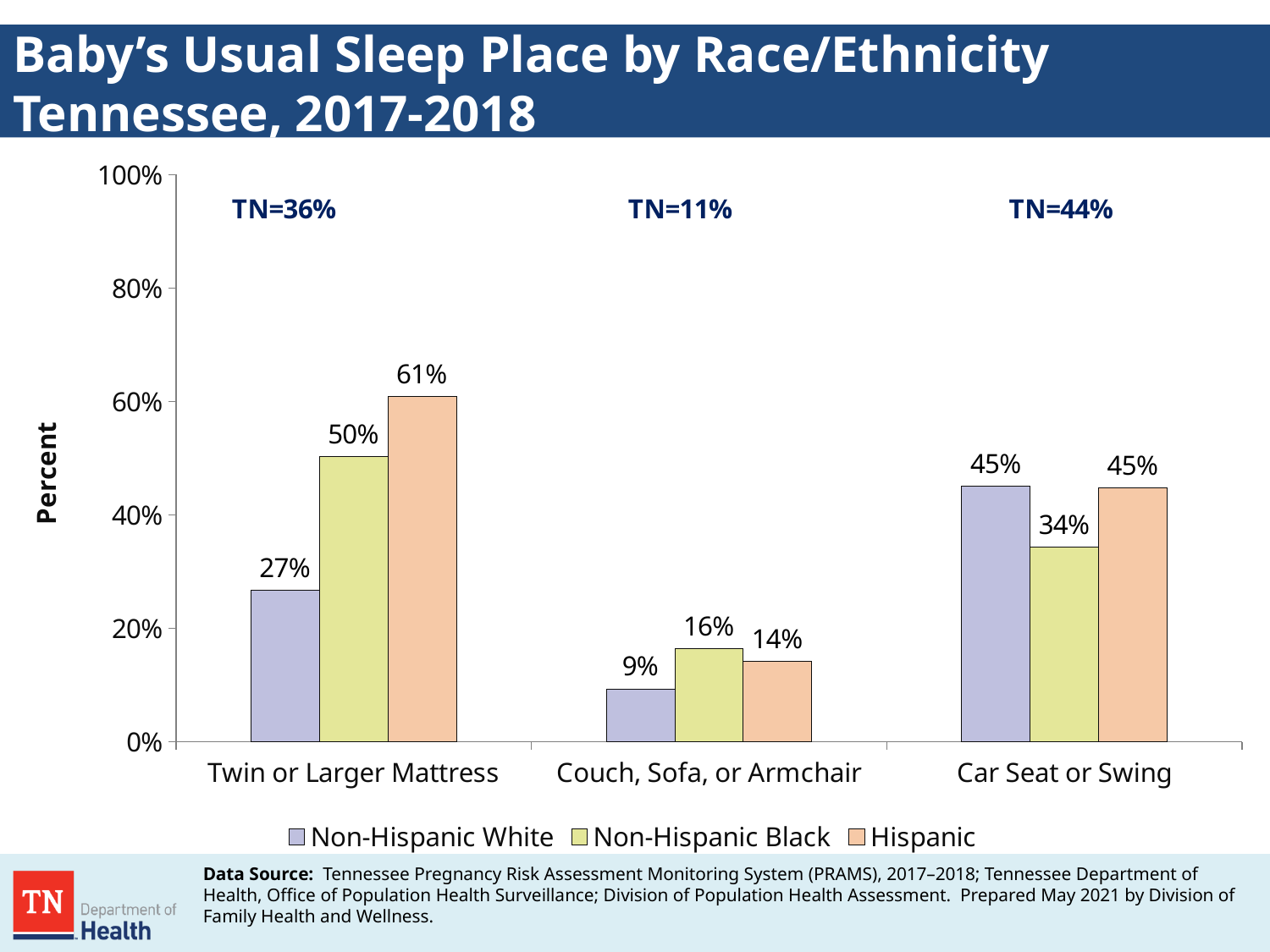
What is the value for Non-Hispanic Black in the Car Seat or Swing category? 34% What is the value for Hispanic in the Twin or Larger Mattress category? 61% What is the label on the y axis? Percent What is the value for Non-Hispanic White in the Couch, Sofa, or Armchair category? 9% How many sleep place categories are shown on the x axis? 3 What is the Tennessee overall value (TN=) shown above the Car Seat or Swing category? 44% Which is larger: the Non-Hispanic Black value for Twin or Larger Mattress or the Non-Hispanic Black value for Car Seat or Swing? Twin or Larger Mattress Which race/ethnicity group has the lowest value in the Couch, Sofa, or Armchair category? Non-Hispanic White What is the difference between the Hispanic and Non-Hispanic White values in the Twin or Larger Mattress category? 34% How many series does the legend list? 3 Which race/ethnicity group has the highest value in the Twin or Larger Mattress category? Hispanic What kind of chart is shown on the slide? Bar chart